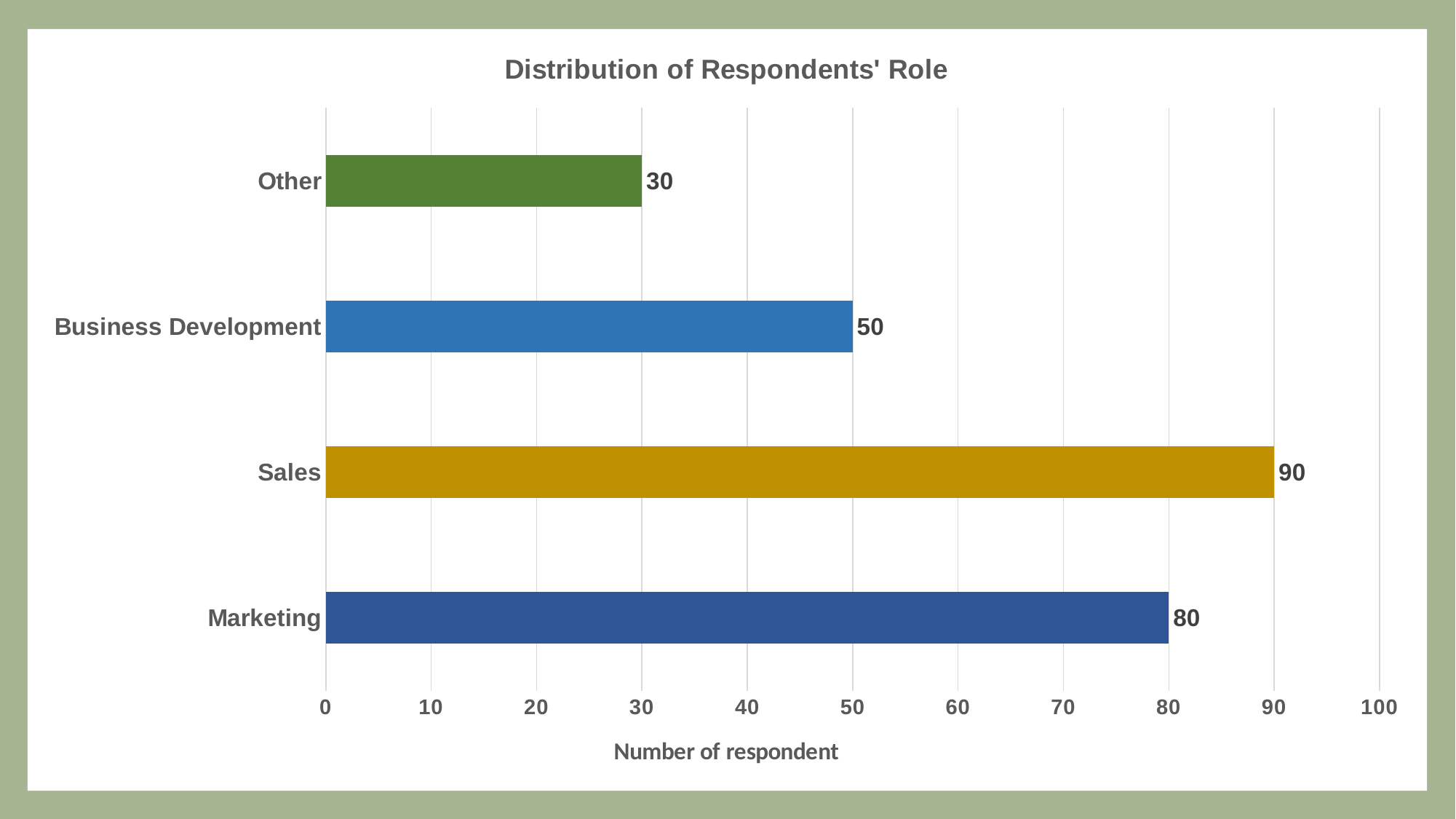
What is the number of respondents for Business Development? 50 Which role has the lowest number of respondents? Other What is the title of the chart? Distribution of Respondents' Role What is the difference between the number of respondents for Sales and Marketing? 10 What kind of chart is shown on the slide? Bar chart What is the number of respondents for Other? 30 Which has more respondents, Marketing or Business Development? Marketing Is the value for Business Development greater or less than 40? greater What is the difference between the number of respondents for Business Development and Other? 20 How many roles are shown in the chart? 4 Which role has the highest number of respondents? Sales What is the number of respondents for Sales? 90